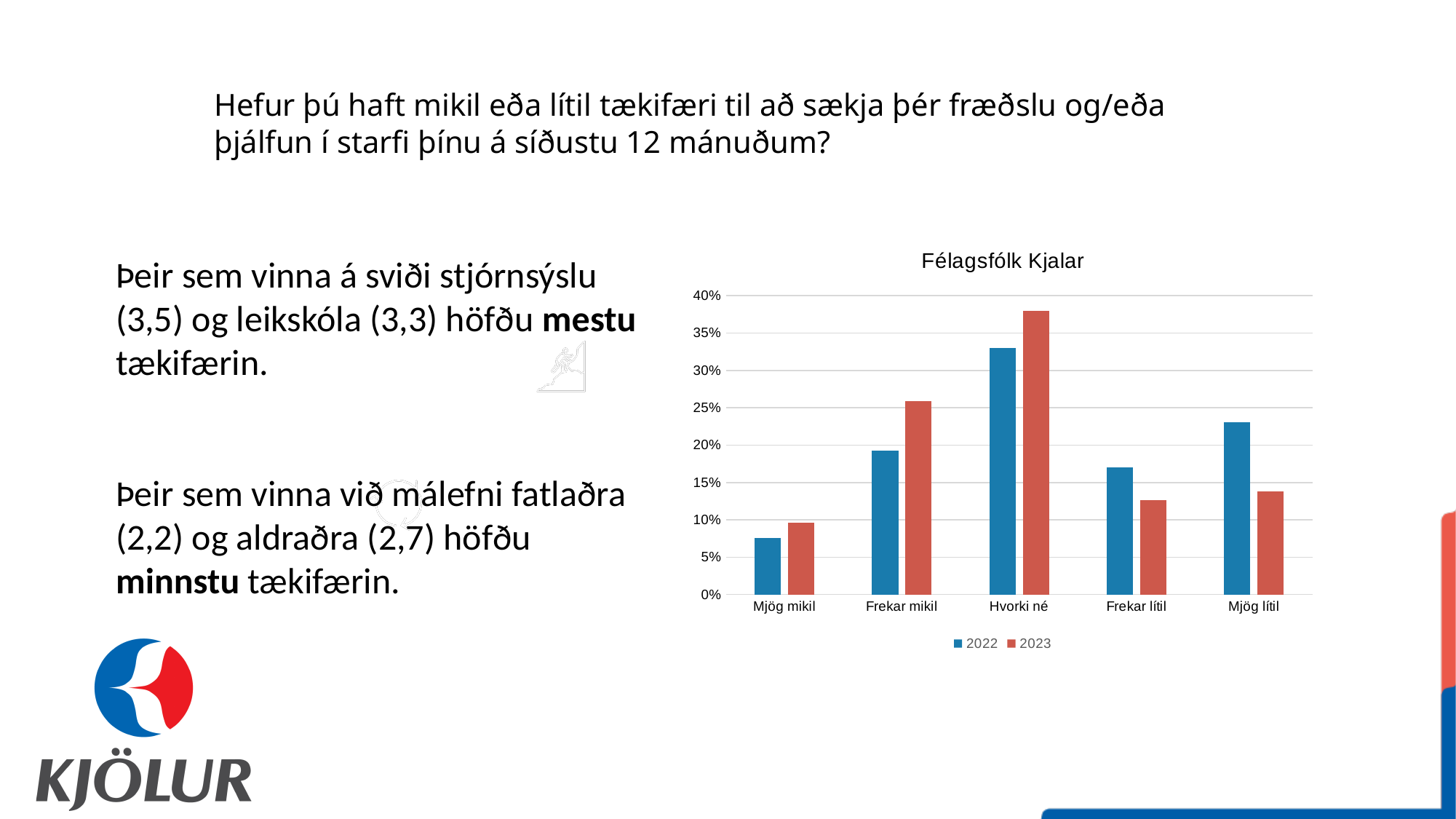
How many categories are shown on the x axis of the chart? 5 Which category has the highest value for 2023? Hvorki né For Mjög lítil, which series has the larger value, 2022 or 2023? 2022 Is the value for Mjög mikil in 2022 greater or less than 10%? less Which category has the lowest value for 2022? Mjög mikil What is the title of the chart? Félagsfólk Kjalar What kind of chart is shown on the slide? bar chart Which category has the highest value for 2022? Hvorki né For Frekar mikil, which series has the larger value, 2022 or 2023? 2023 Is the value for Hvorki né in 2023 greater or less than 35%? greater How many series does the chart's legend list? 2 Which category has the lowest value for 2023? Mjög mikil